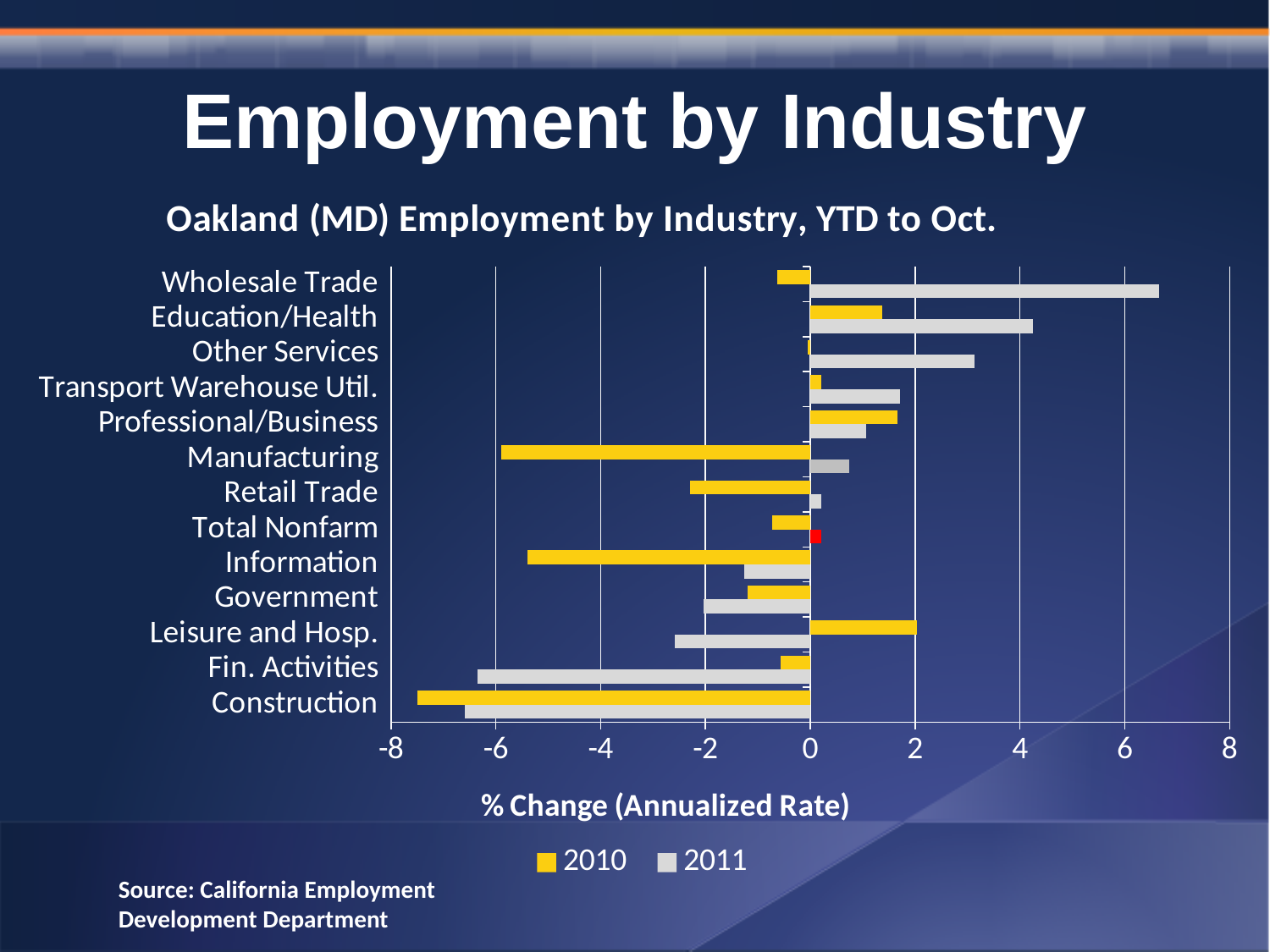
What is the label on the x axis of the chart? % Change (Annualized Rate) What kind of chart is shown on the slide? bar chart Which industry has the highest 2011 value? Wholesale Trade Which industry has the lowest 2010 value? Construction Is the 2010 value for Manufacturing greater or less than -4? less Is the 2011 value for Fin. Activities greater or less than -6? less Is the 2011 value for Education/Health greater or less than 4? greater How many industry categories are plotted on the chart? 13 Which is larger for Leisure and Hosp., the 2010 value or the 2011 value? 2010 How many series does the legend list? 2 Which is larger for Information, the 2010 value or the 2011 value? 2011